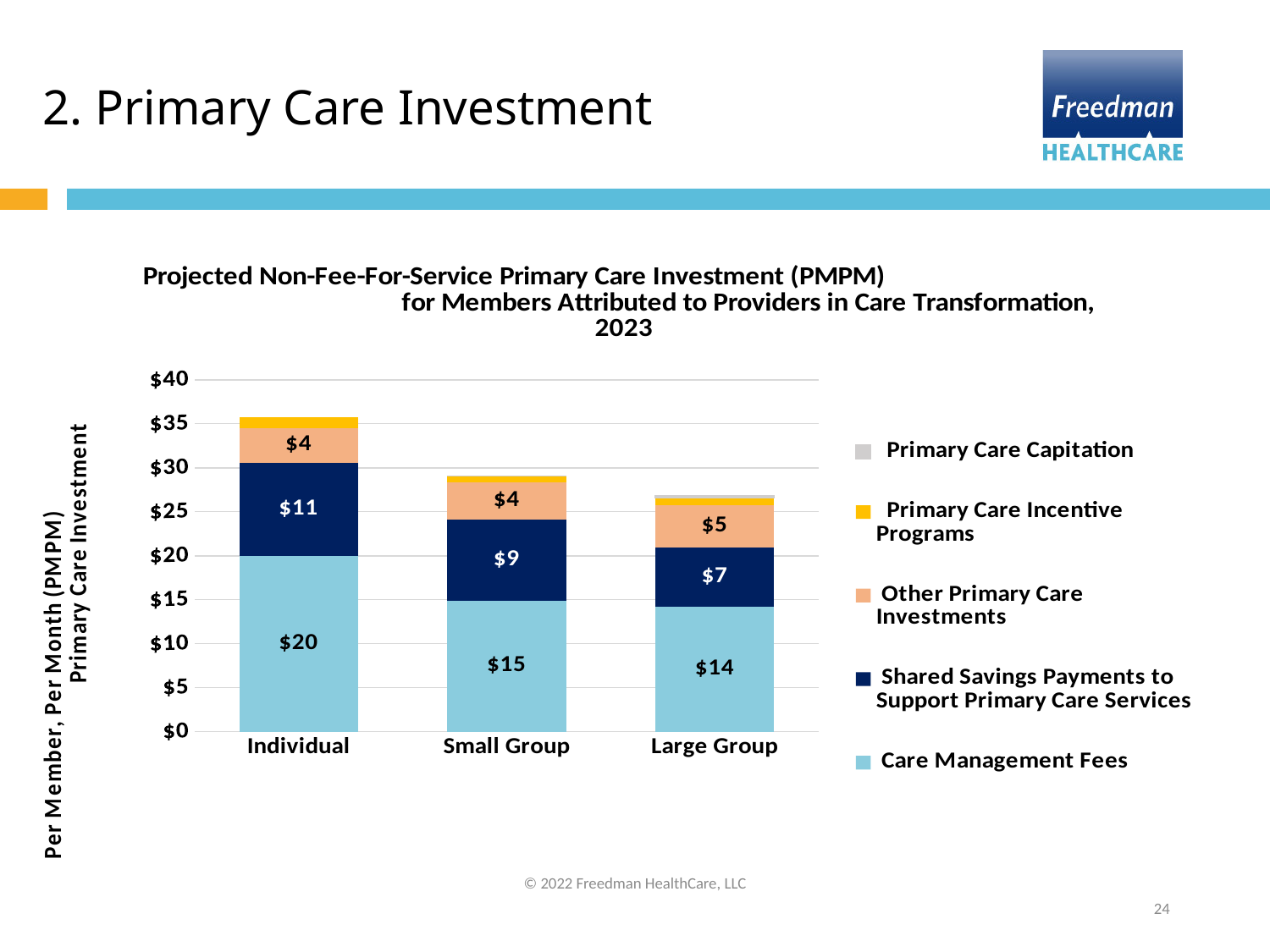
Which is larger: the Shared Savings Payments value for Individual or for Small Group? Individual Which category has the highest Care Management Fees value? Individual Which category has the lowest Shared Savings Payments to Support Primary Care Services value? Large Group What type of chart is shown on the slide? stacked bar chart What is the difference between the Care Management Fees values for Individual and Large Group? $6 Which series is shown in yellow in the legend? Primary Care Incentive Programs How many categories are shown on the x axis of the chart? 3 What is the Care Management Fees value for Individual? $20 What is the Shared Savings Payments to Support Primary Care Services value for Small Group? $9 What is the Other Primary Care Investments value for Large Group? $5 Is the total stacked value for Small Group greater or less than $30? less How many series does the chart's legend list? 5